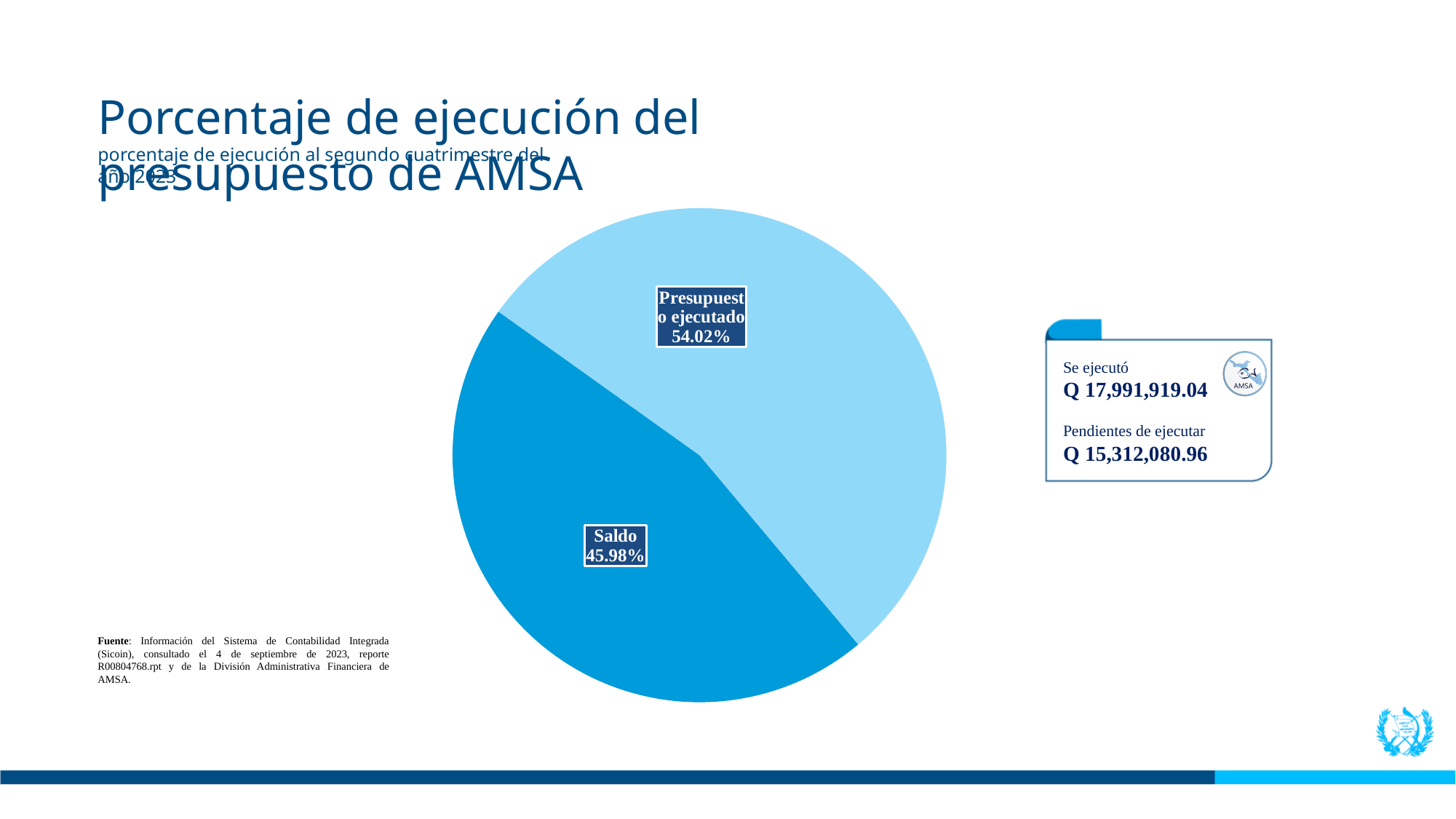
Is the share of the Presupuesto ejecutado slice greater or less than 50%? greater What share of the pie does the Saldo slice represent? 45.98% How many slices does the pie chart have? 2 What colour is the Saldo slice of the pie chart? blue What kind of chart is shown on the slide? pie chart What percentage is shown for the Saldo slice? 45.98% What is the title of the slide containing the pie chart? Porcentaje de ejecución del presupuesto de AMSA Which slice of the pie chart is the largest? Presupuesto ejecutado Which is larger, the Presupuesto ejecutado slice or the Saldo slice? Presupuesto ejecutado What is the difference in percentage points between the Presupuesto ejecutado slice and the Saldo slice? 8.04 Which slice of the pie chart is the smallest? Saldo What percentage is shown for the Presupuesto ejecutado slice? 54.02%